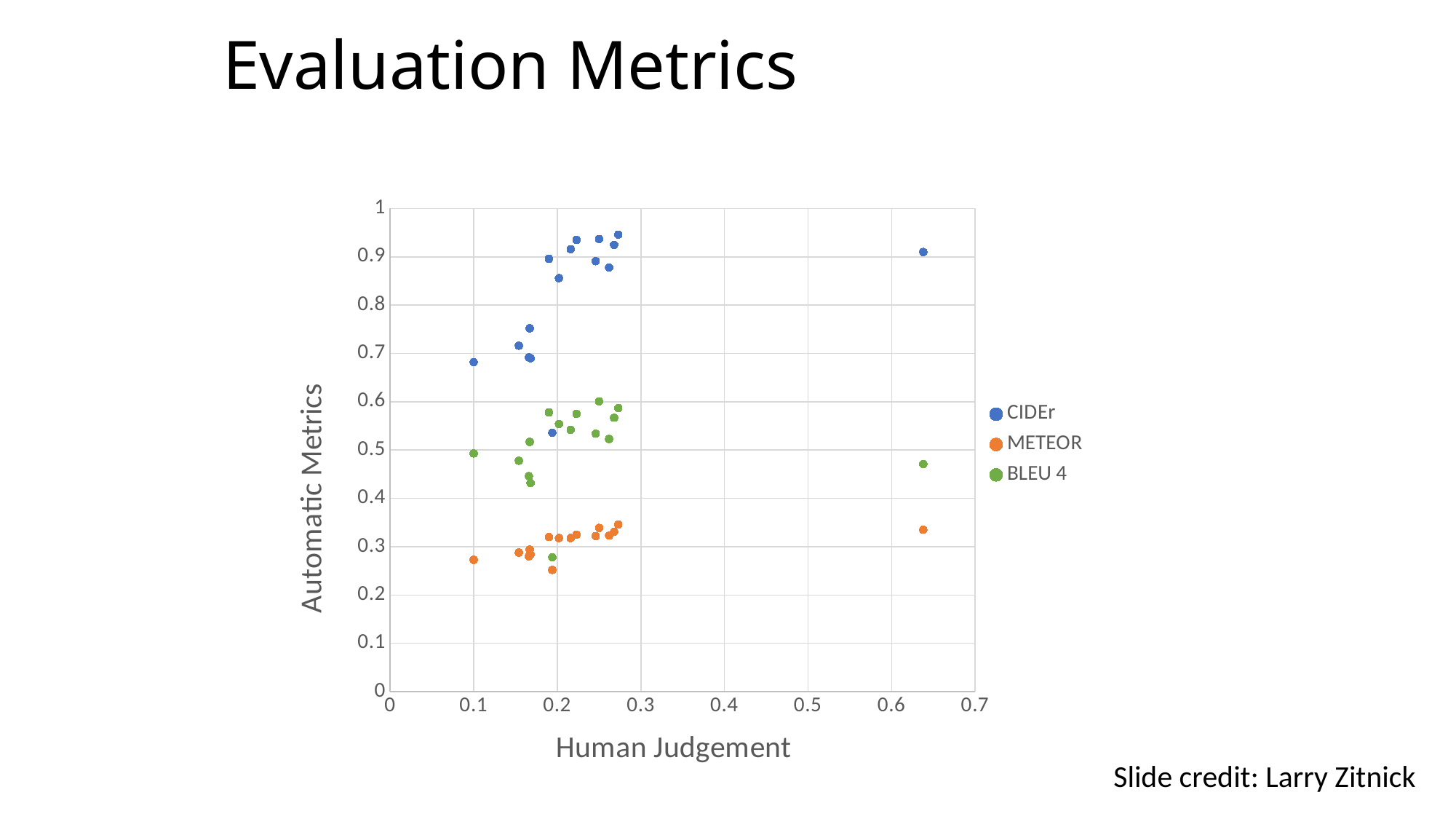
Is the CIDEr value at Human Judgement 0.64 greater or less than 0.8? greater How many series does the legend list? 3 At Human Judgement 0.64, which is larger, the CIDEr value or the BLEU 4 value? CIDEr Which series has the highest Automatic Metrics values overall? CIDEr Is the CIDEr value at Human Judgement 0.1 greater or less than 0.6? greater What kind of chart is shown on the slide? Scatter chart What is the title of the horizontal axis? Human Judgement What is the title of the vertical axis? Automatic Metrics Is the METEOR value at Human Judgement 0.64 greater or less than 0.4? less Which series has the lowest Automatic Metrics values overall? METEOR Do the CIDEr values generally rise or fall as Human Judgement increases from 0.1 to 0.3? rise